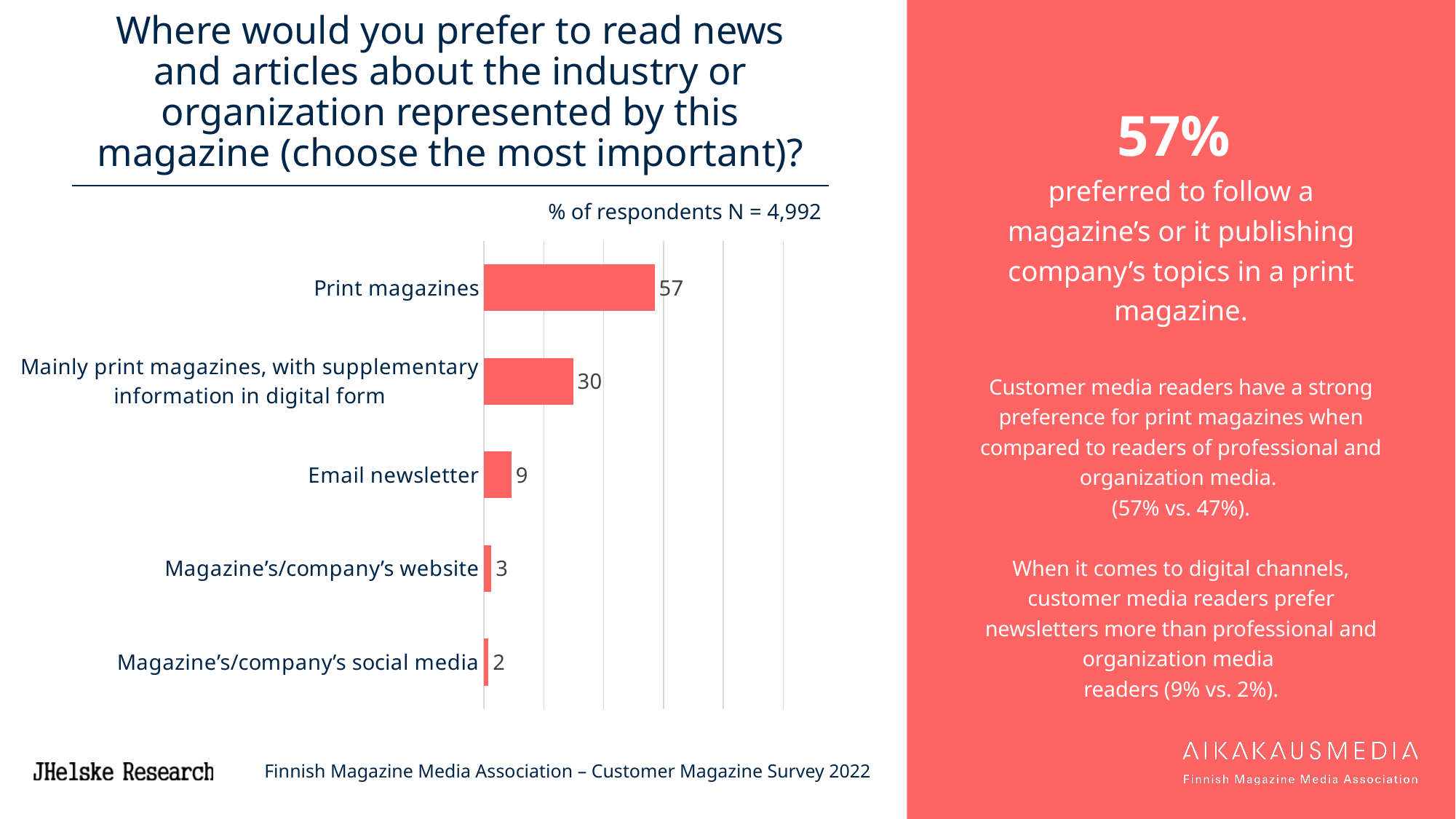
What is the number of respondents (N) stated above the chart? 4,992 What kind of chart is shown on the slide? Bar chart What is the value for Mainly print magazines, with supplementary information in digital form? 30 What is the difference between the values for Email newsletter and Magazine's/company's social media? 7 Which is larger: the value for Email newsletter or the value for Magazine's/company's website? Email newsletter What is the difference between the values for Print magazines and Mainly print magazines, with supplementary information in digital form? 27 How many categories are shown in the chart? 5 What percentage of respondents chose Print magazines? 57 Which category has the lowest value? Magazine's/company's social media What is the value for Email newsletter? 9 Which category has the highest value? Print magazines What is the value for Magazine's/company's social media? 2